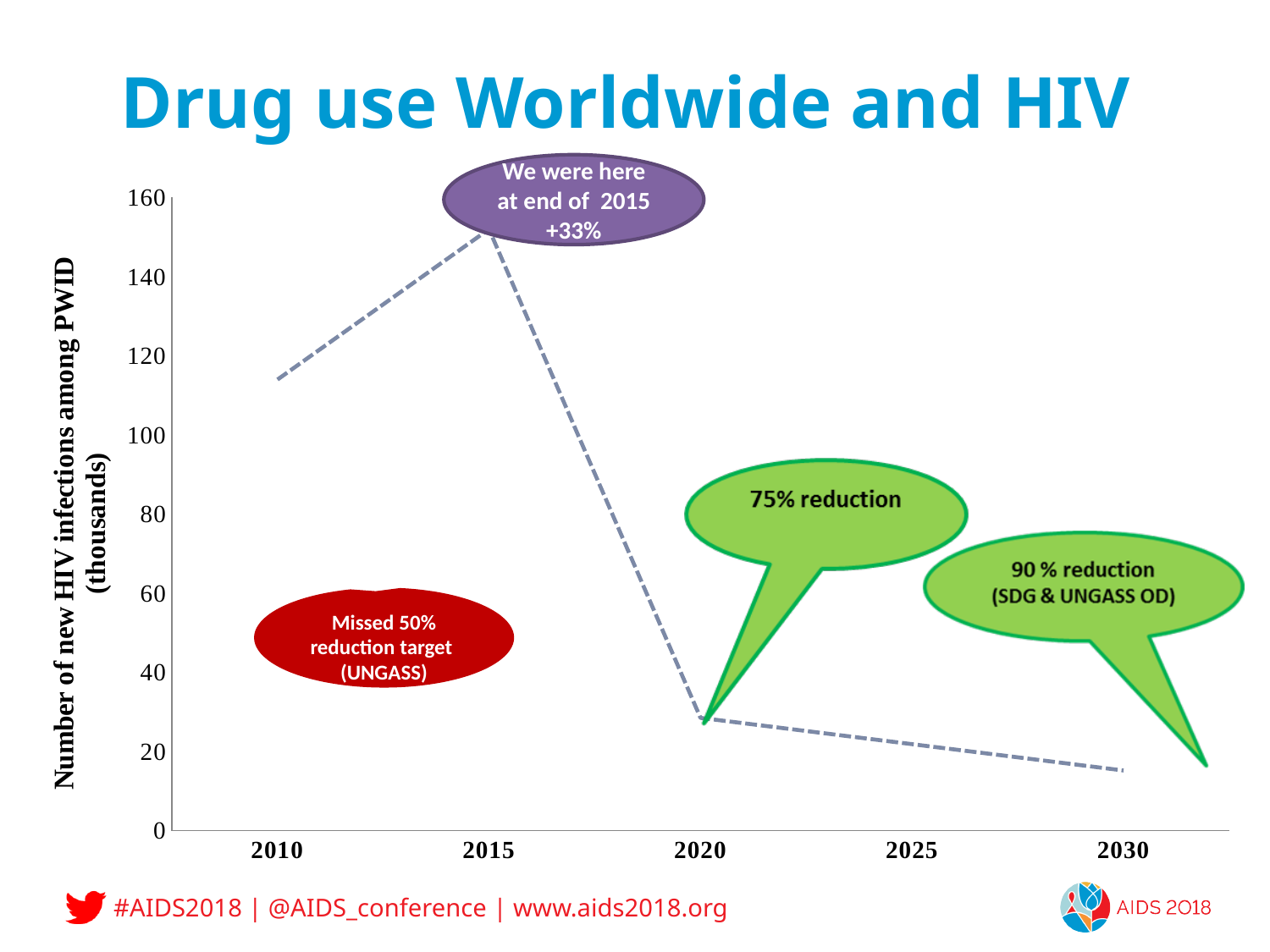
What is the label on the y axis? Number of new HIV infections among PWID (thousands) Which year has the highest number of new HIV infections among PWID on the chart? 2015 Which is larger, the value for 2010 or the value for 2015? 2015 Is the value for 2010 greater or less than 100? greater Is the value for 2020 greater or less than 40? less What kind of chart is shown on the slide? line chart Is the value for 2015 greater or less than 140? greater Which year has the lowest number of new HIV infections among PWID on the chart? 2030 Which is larger, the value for 2020 or the value for 2030? 2020 How many year labels are shown on the x axis? 5 Does the line rise or fall between 2015 and 2020? fall